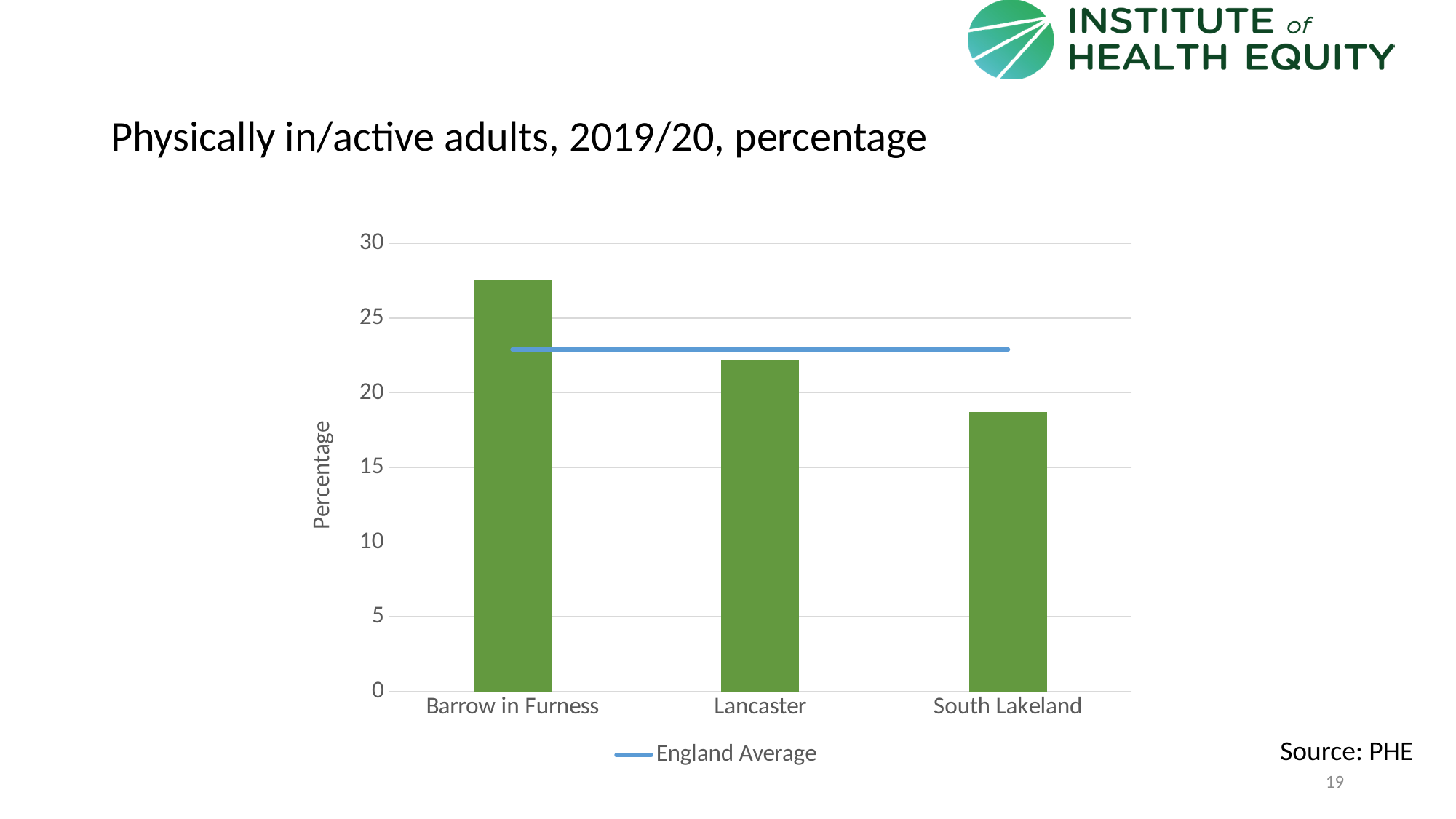
What does the horizontal blue line in the chart represent, according to the legend? England Average Is the value for Barrow in Furness greater or less than 25? greater How many areas (categories) are plotted on the x axis of the chart? 3 Which area has the lowest percentage in the chart? South Lakeland Is the value for South Lakeland greater or less than 20? less Do the bar values rise or fall moving from left to right across the x axis? fall Which is larger, the value for Lancaster or the value for South Lakeland? Lancaster What kind of chart is shown on the slide? combination bar and line chart (bars with an England Average line) Which is larger, the value for Barrow in Furness or the value for Lancaster? Barrow in Furness What is the title of the chart on the slide? Physically in/active adults, 2019/20, percentage Which area has the highest percentage of physically inactive adults in the chart? Barrow in Furness Is the value for Lancaster greater or less than 20? greater